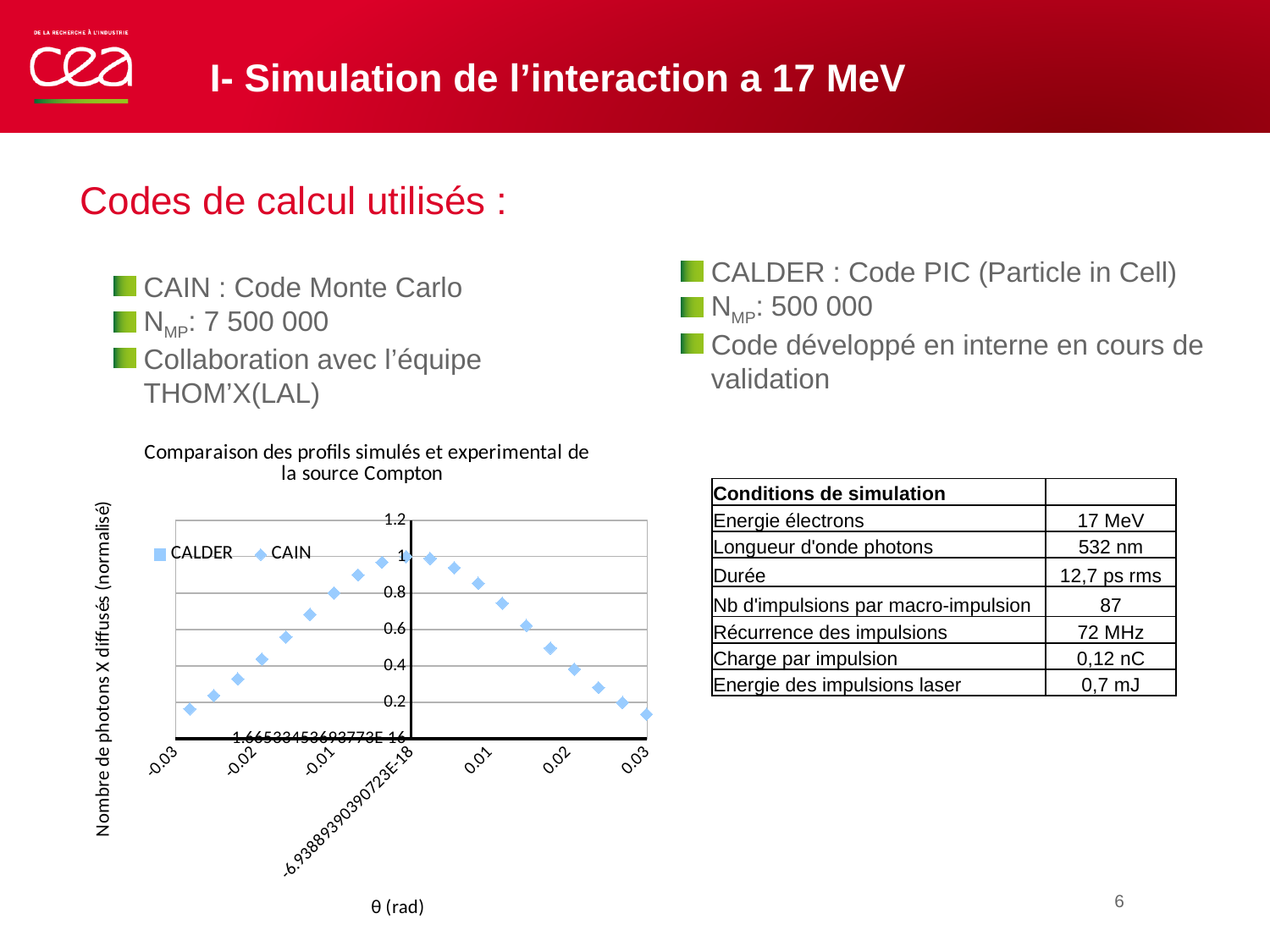
How many series does the chart legend list? 2 Is the plotted value at θ = -0.02 greater or less than 0.4? less How do the plotted values change as θ goes from -0.03 to 0? they rise Around which θ value does the plotted profile reach its maximum? 0 What is the label of the x axis of the chart? θ (rad) Is the plotted value at θ = 0.03 greater or less than 0.2? less What kind of chart is shown on the slide? scatter chart Is the plotted value at θ = -0.03 greater or less than 0.2? less What are the two series named in the chart legend? CALDER and CAIN Which has the larger plotted value, θ = 0 or θ = 0.03? θ = 0